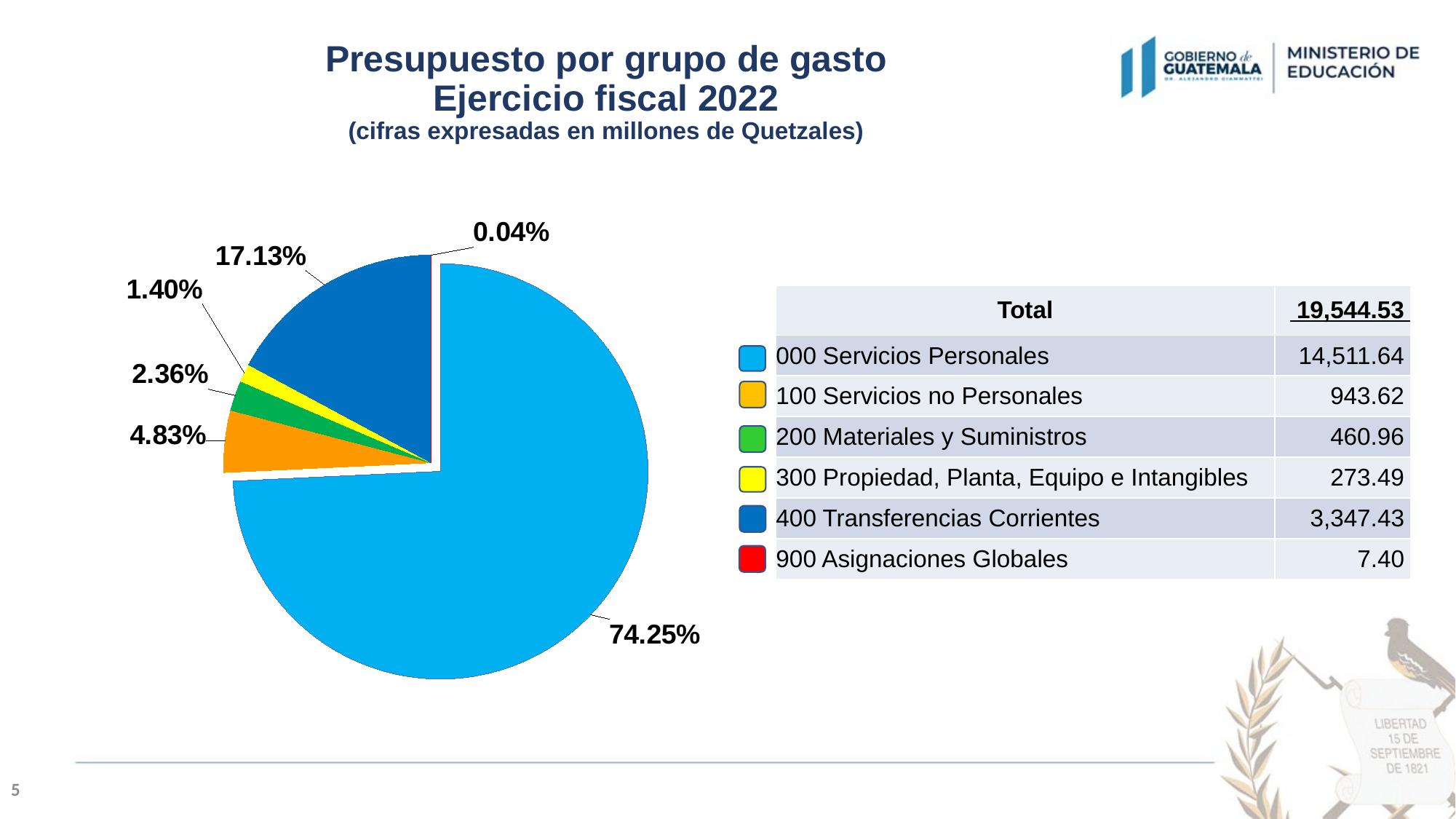
What colour is the slice for 400 Transferencias Corrientes? dark blue What share of the pie does 400 Transferencias Corrientes represent? 17.13% What share of the pie does 100 Servicios no Personales represent? 4.83% Which slice is larger: 200 Materiales y Suministros or 100 Servicios no Personales? 100 Servicios no Personales What share of the pie does 300 Propiedad, Planta, Equipo e Intangibles represent? 1.40% How many slices does the pie chart have? 6 What is the total budget shown in the table next to the pie chart? 19,544.53 Which category has the smallest slice of the pie? 900 Asignaciones Globales Which category has the largest slice of the pie? 000 Servicios Personales What is the difference in percentage points between the 000 Servicios Personales slice and the 400 Transferencias Corrientes slice? 57.12% What kind of chart is shown on the slide? pie chart